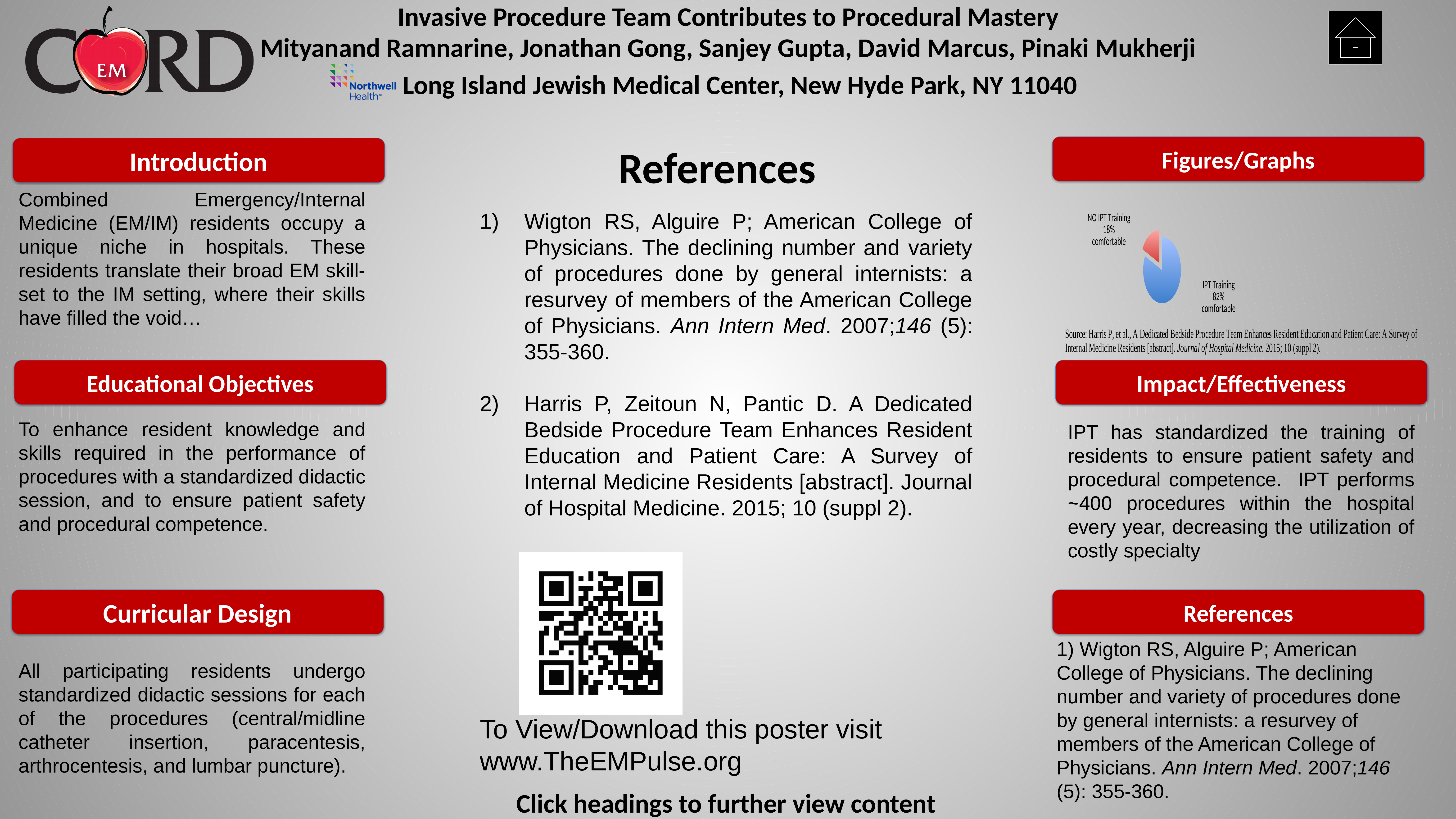
In the pie chart, what percentage is shown for NO IPT Training? 18% In the pie chart, what percentage is shown for IPT Training? 82% How many slices does the pie chart have? 2 What colour is the NO IPT Training slice in the pie chart? red What share of the pie does the NO IPT Training slice represent? 18% Which is larger in the pie chart: IPT Training or NO IPT Training? IPT Training What colour is the IPT Training slice in the pie chart? blue What kind of chart is shown in the Figures/Graphs section? pie chart Which slice of the pie chart is the largest? IPT Training Which slice of the pie chart is the smallest? NO IPT Training What is the difference in percentage points between the IPT Training and NO IPT Training slices? 64